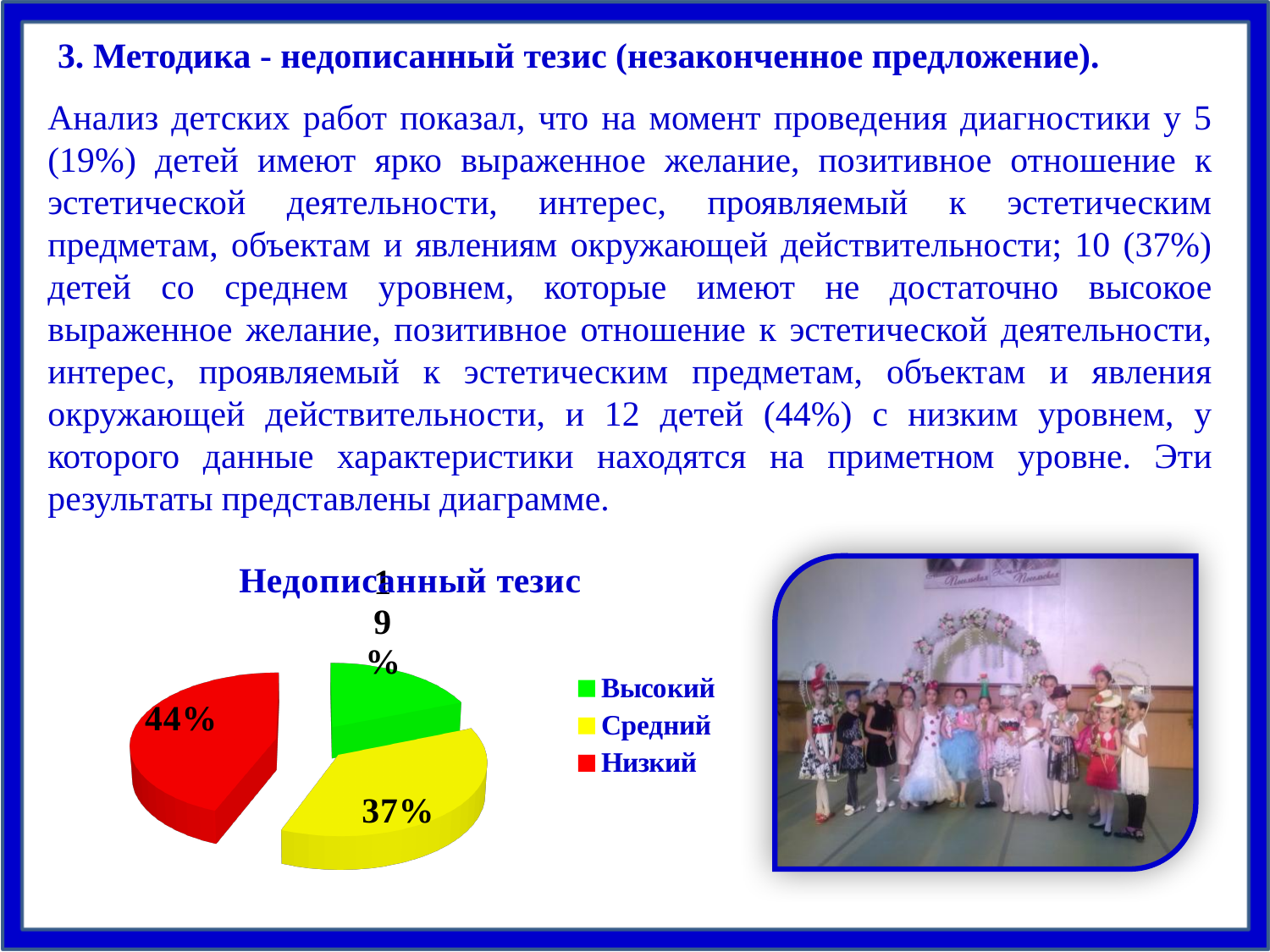
Which category has the largest slice of the pie? Низкий Which is larger, the Средний slice or the Высокий slice? Средний How many slices does the pie chart have? 3 What is the title of the chart? Недописанный тезис What kind of chart is shown on the slide? pie chart What share of the pie does the Высокий slice represent? 19% What share of the pie does the Низкий slice represent? 44% What colour is the Низкий slice in the pie chart? red What share of the pie does the Средний slice represent? 37% How many entries does the chart legend list? 3 Which category has the smallest slice of the pie? Высокий What is the difference in percentage points between the Низкий and Средний slices? 7%